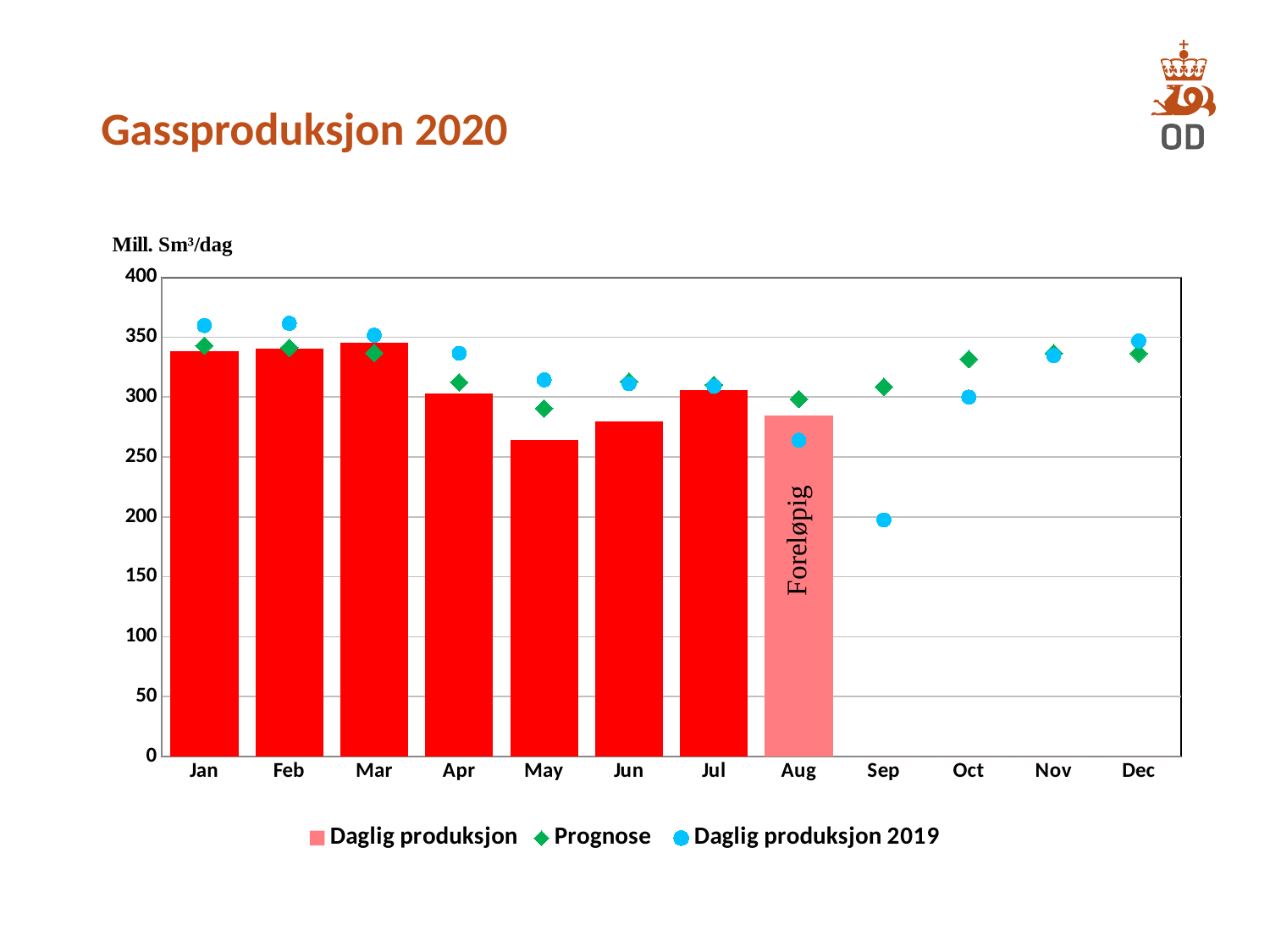
Which month has the lowest Daglig produksjon bar? May How many months have a bar for Daglig produksjon? 8 What kind of chart is shown on the slide? bar chart Is the Daglig produksjon 2019 value for Feb greater or less than 350? greater How many series does the legend list? 3 Which is larger for Jan: the Daglig produksjon bar or the Daglig produksjon 2019 point? Daglig produksjon 2019 Is the Daglig produksjon value for May greater or less than 300? less Which month has the highest Daglig produksjon bar? Mar What unit is shown on the y axis of the chart? Mill. Sm³/dag Do the Daglig produksjon bars rise or fall from Mar to May? fall Which is larger for Sep: the Prognose point or the Daglig produksjon 2019 point? Prognose Is the Daglig produksjon value for Jan greater or less than 300? greater